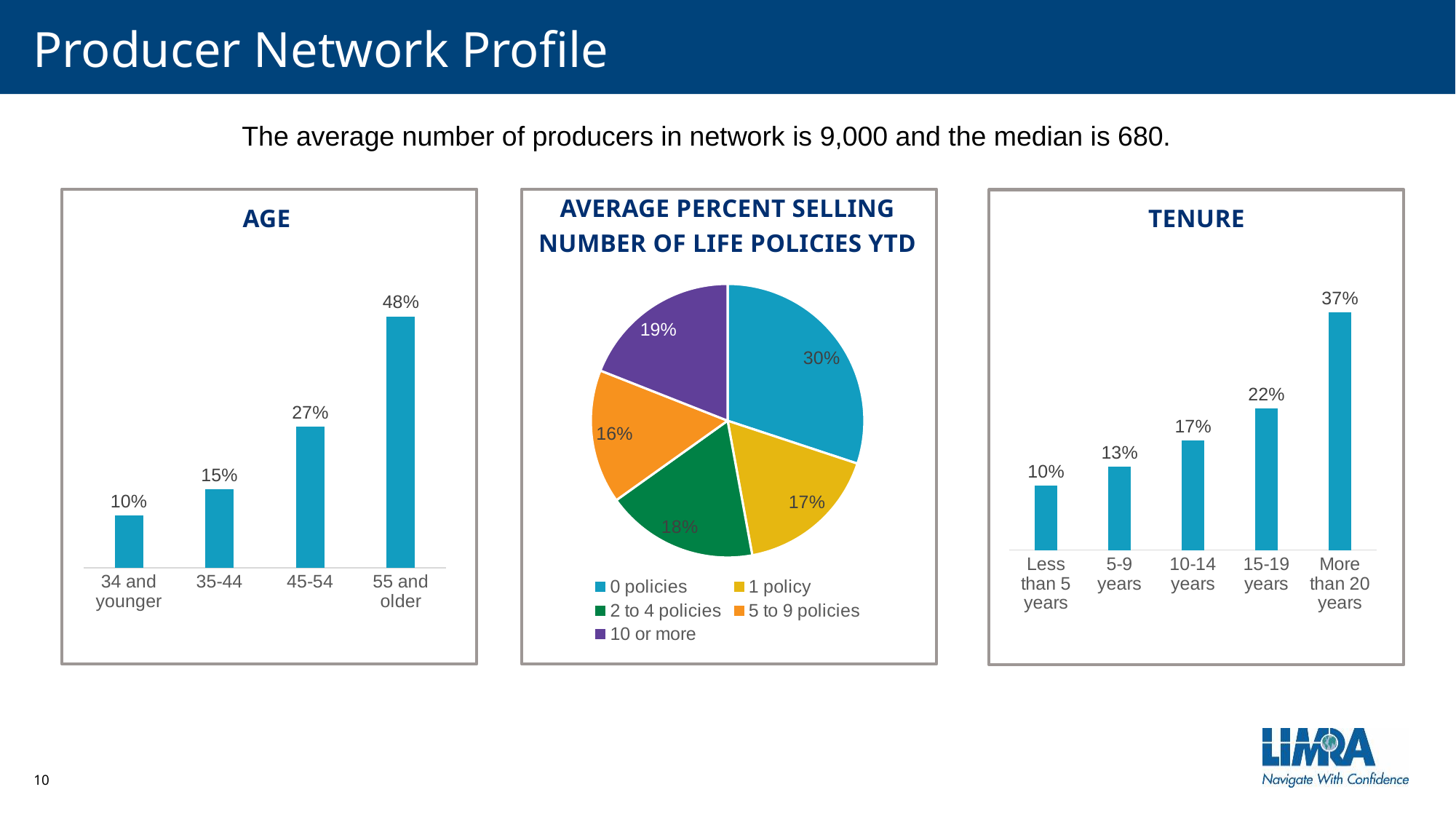
What type of chart is the TENURE chart? bar chart How many slices does the AVERAGE PERCENT SELLING NUMBER OF LIFE POLICIES YTD pie chart have? 5 In the TENURE chart, what percentage of producers have 15-19 years of tenure? 22% In the AGE chart, which age group has the lowest percentage? 34 and younger In the AGE chart, do the values rise or fall from the youngest to the oldest age group? rise In the TENURE chart, which tenure group has the highest percentage? More than 20 years In the TENURE chart, which is larger: 5-9 years or 10-14 years? 10-14 years In the AVERAGE PERCENT SELLING NUMBER OF LIFE POLICIES YTD pie chart, what colour is the 10 or more slice? purple In the AVERAGE PERCENT SELLING NUMBER OF LIFE POLICIES YTD pie chart, what share is 0 policies? 30% In the AVERAGE PERCENT SELLING NUMBER OF LIFE POLICIES YTD pie chart, which category has the smallest slice? 5 to 9 policies In the AGE chart, what is the difference between the 45-54 and 35-44 groups? 12 percentage points In the AGE chart, what percentage of producers are 55 and older? 48%